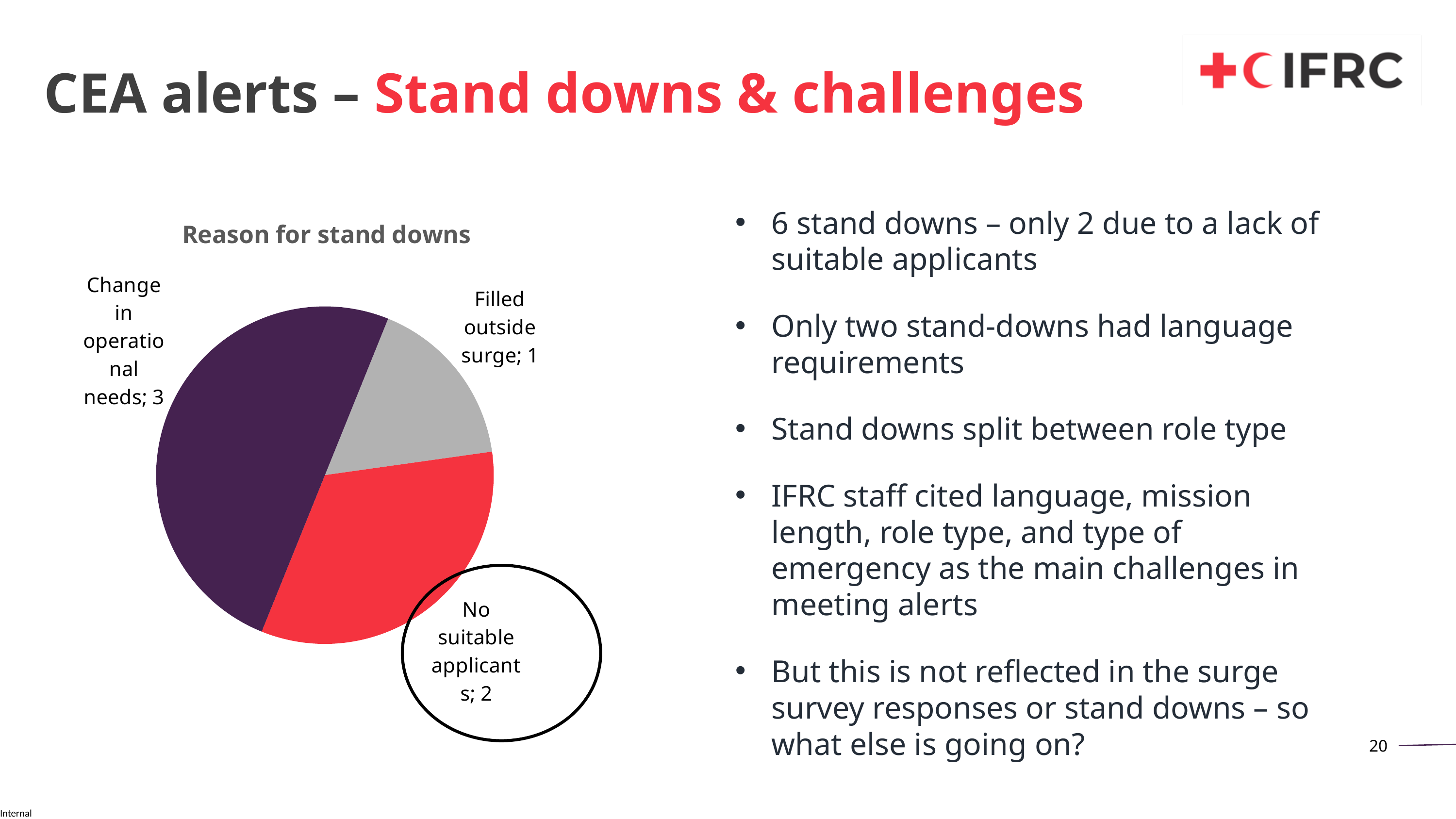
How many categories does the pie chart show? 3 Which reason for stand downs has the lowest value? Filled outside surge What is the value for 'No suitable applicants' in the pie chart? 2 What is the value for 'Filled outside surge' in the pie chart? 1 Which reason for stand downs has the highest value? Change in operational needs What is the total of all slices in the pie chart? 6 What is the title of the pie chart? Reason for stand downs Which is larger: the value for 'No suitable applicants' or 'Filled outside surge'? No suitable applicants What is the value for 'Change in operational needs' in the pie chart? 3 What is the difference between the values for 'Change in operational needs' and 'Filled outside surge'? 2 What share of the pie does 'Change in operational needs' represent? 50% What type of chart is shown on the slide? pie chart